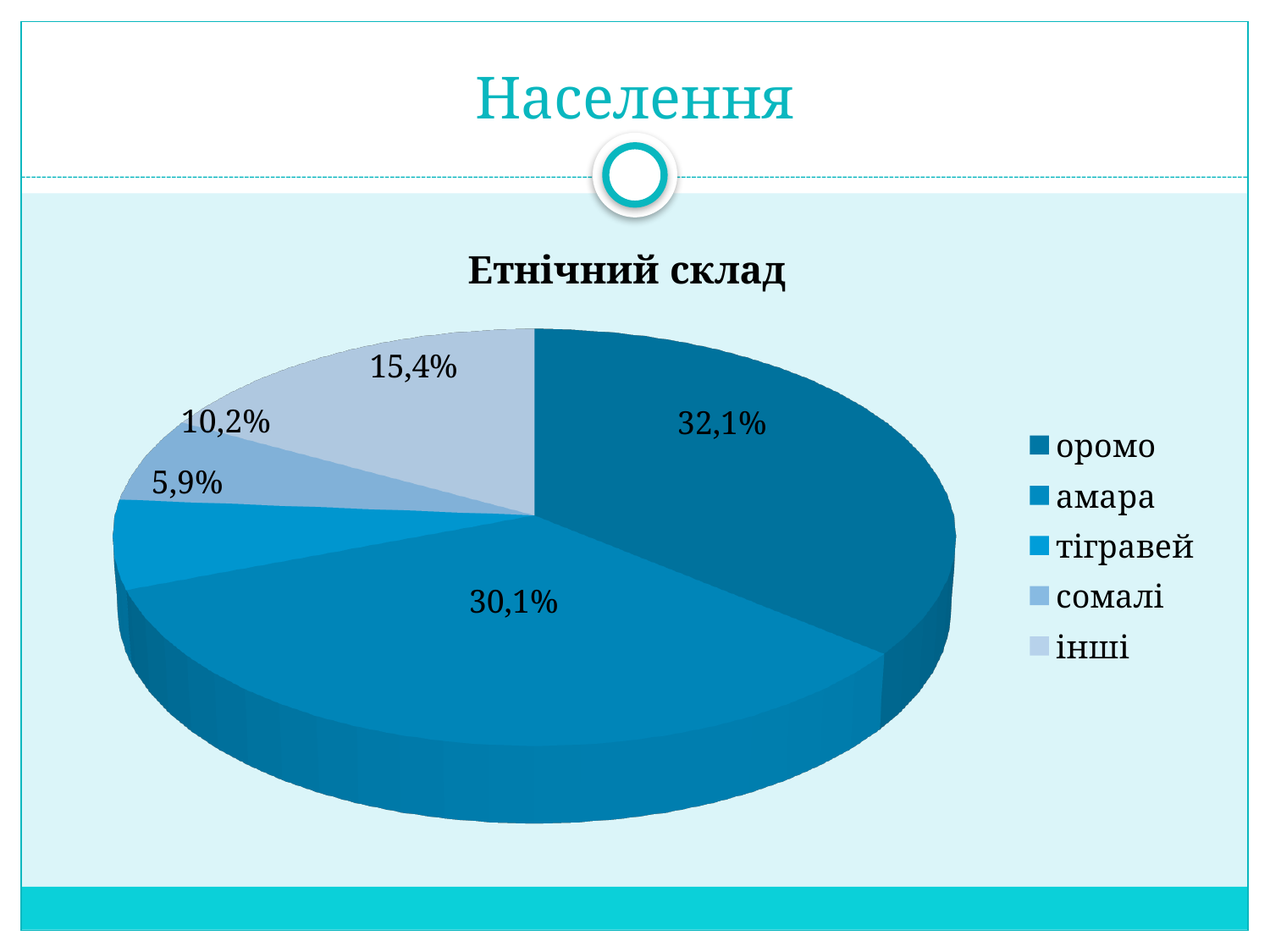
What share of the pie does оромо have? 32,1% What share of the pie does амара have? 30,1% What kind of chart is shown on the slide? pie chart How many categories does the legend list? 5 What share of the pie does інші have? 15,4% Which category has the largest slice of the pie? оромо What is the difference between the shares of оромо and амара? 2,0% Which is larger, the share of сомалі or the share of інші? інші What is the title of the chart? Етнічний склад